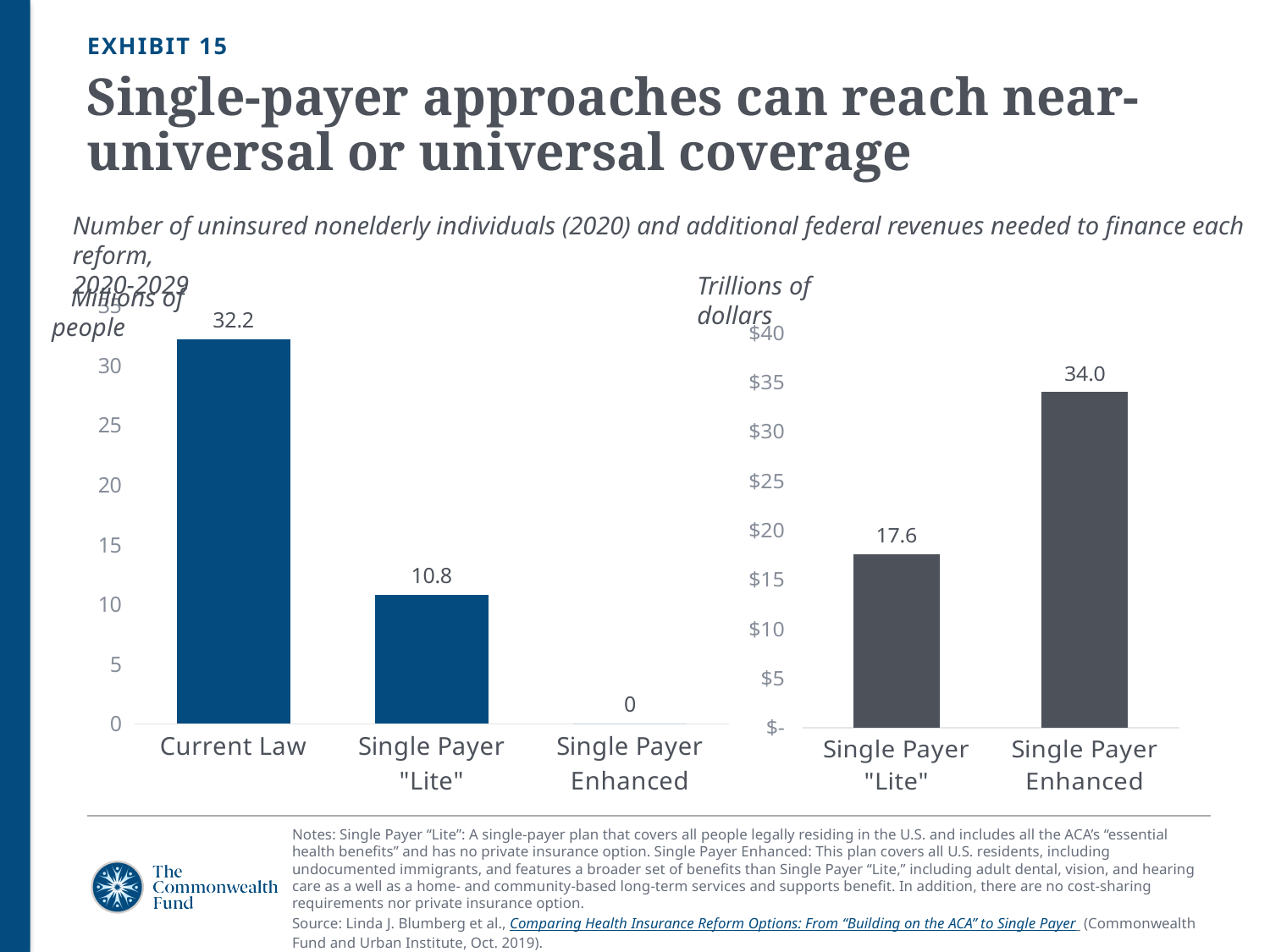
In the right chart (trillions of dollars), which category has the higher value? Single Payer Enhanced In the left chart (millions of people), which category has the highest value? Current Law In the left chart (millions of people), which category has the lowest value? Single Payer Enhanced How many categories are shown in the left chart (millions of people)? 3 What type of chart is the right chart (trillions of dollars)? Bar chart In the right chart (trillions of dollars), what is the difference between Single Payer Enhanced and Single Payer "Lite"? 16.4 In the left chart (millions of people), what is the difference between Current Law and Single Payer "Lite"? 21.4 In the left chart (millions of people), what is the value for Single Payer Enhanced? 0 In the right chart (trillions of dollars), what is the value for Single Payer Enhanced? 34.0 In the left chart (millions of people), what is the value for Single Payer "Lite"? 10.8 In the left chart (millions of people), what is the value for Current Law? 32.2 In the right chart (trillions of dollars), what is the value for Single Payer "Lite"? 17.6